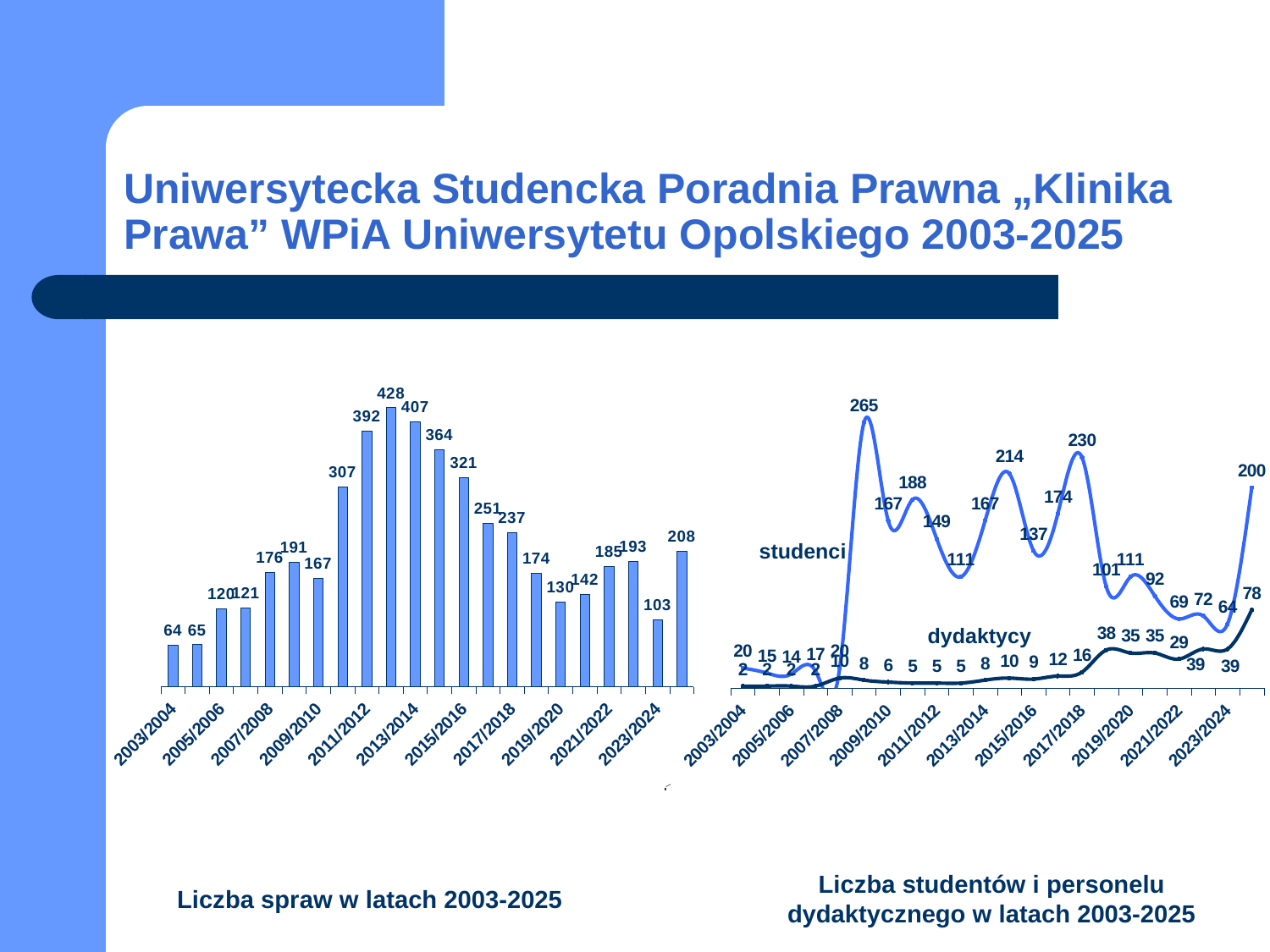
How many bars are plotted in the left chart 'Liczba spraw w latach 2003-2025'? 22 In the left chart 'Liczba spraw w latach 2003-2025', what is the highest value shown? 428 How many series are plotted in the right chart 'Liczba studentów i personelu dydaktycznego w latach 2003-2025'? 2 In the left chart 'Liczba spraw w latach 2003-2025', what is the lowest value shown? 64 In the right chart 'Liczba studentów i personelu dydaktycznego w latach 2003-2025', what is the highest value of the 'studenci' series? 265 In the right chart 'Liczba studentów i personelu dydaktycznego w latach 2003-2025', what is the value of 'dydaktycy' for 2003/2004? 2 What kind of chart is the left chart, 'Liczba spraw w latach 2003-2025'? bar chart In the right chart 'Liczba studentów i personelu dydaktycznego w latach 2003-2025', which series has the larger value for 2023/2024, 'studenci' or 'dydaktycy'? studenci In the right chart 'Liczba studentów i personelu dydaktycznego w latach 2003-2025', what is the value of 'studenci' for 2023/2024? 64 In the left chart 'Liczba spraw w latach 2003-2025', what is the difference between the highest value (428) and the lowest value (64)? 364 In the left chart 'Liczba spraw w latach 2003-2025', what is the value for 2023/2024? 103 What kind of chart is the right chart, 'Liczba studentów i personelu dydaktycznego w latach 2003-2025'? line chart